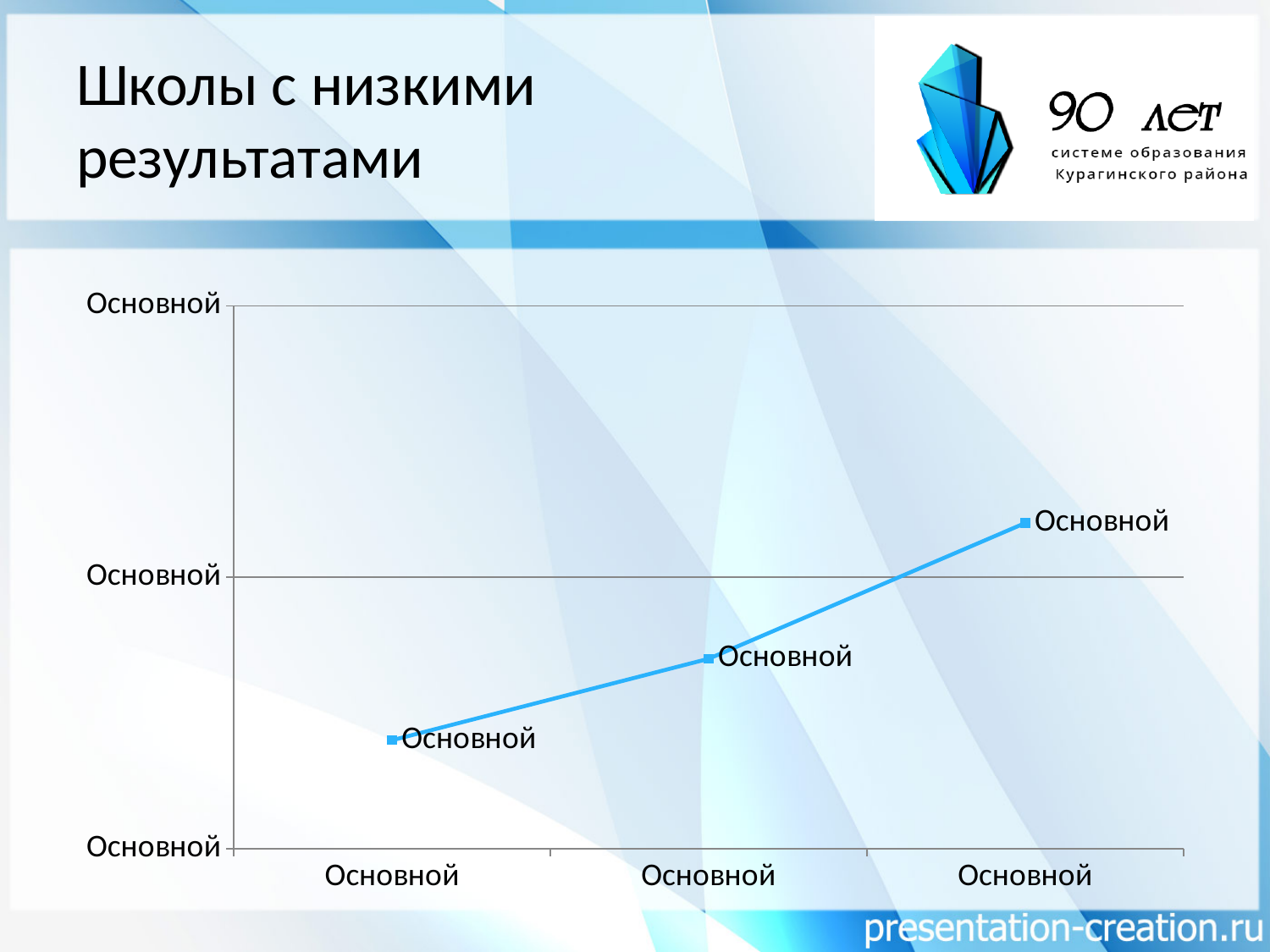
Is the middle point of the line higher or lower than the rightmost point? lower What kind of chart is shown on the slide? line chart Do the values rise or fall from left to right along the x axis? rise Which point on the line is the highest: the leftmost, the middle, or the rightmost? the rightmost What text is shown as the label on each data point of the line? Основной Which point on the line is the lowest: the leftmost, the middle, or the rightmost? the leftmost How many data points are plotted on the line? 3 What is the title of the slide containing the chart? Школы с низкими результатами